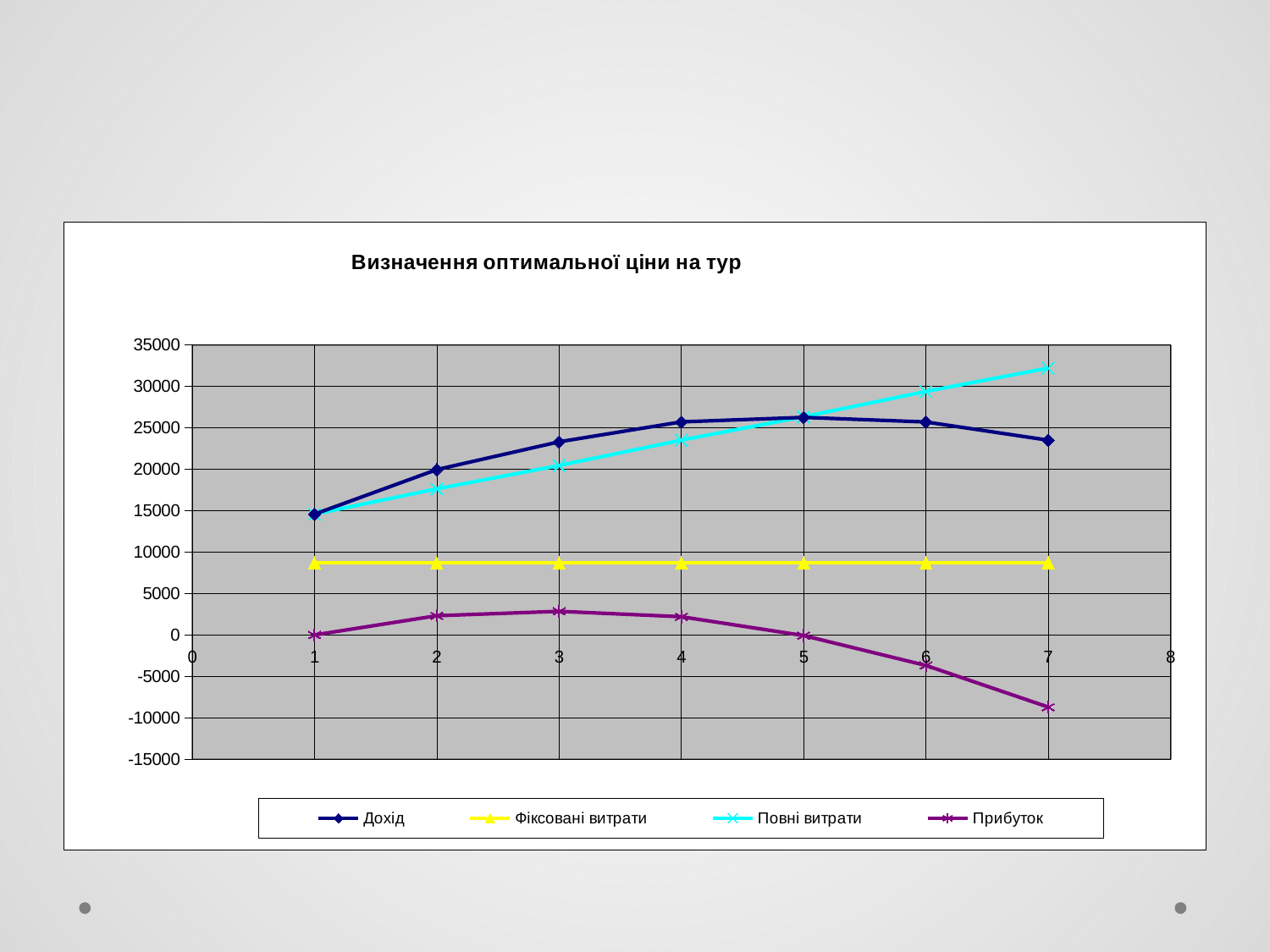
Is the value of Повні витрати at x = 7 greater or less than 30000? greater At x = 7, which series has the lowest value? Прибуток Is the value of Фіксовані витрати greater or less than 10000? less At x = 2, which is larger: Дохід or Повні витрати? Дохід At x = 7, which series has the highest value? Повні витрати What is the title of the chart? Визначення оптимальної ціни на тур What kind of chart is shown on the slide? line chart Does the Повні витрати series rise or fall as x increases from 1 to 7? rises How many series does the legend list? 4 How many data points does the Дохід series have? 7 Is the value of Дохід at x = 3 greater or less than 20000? greater